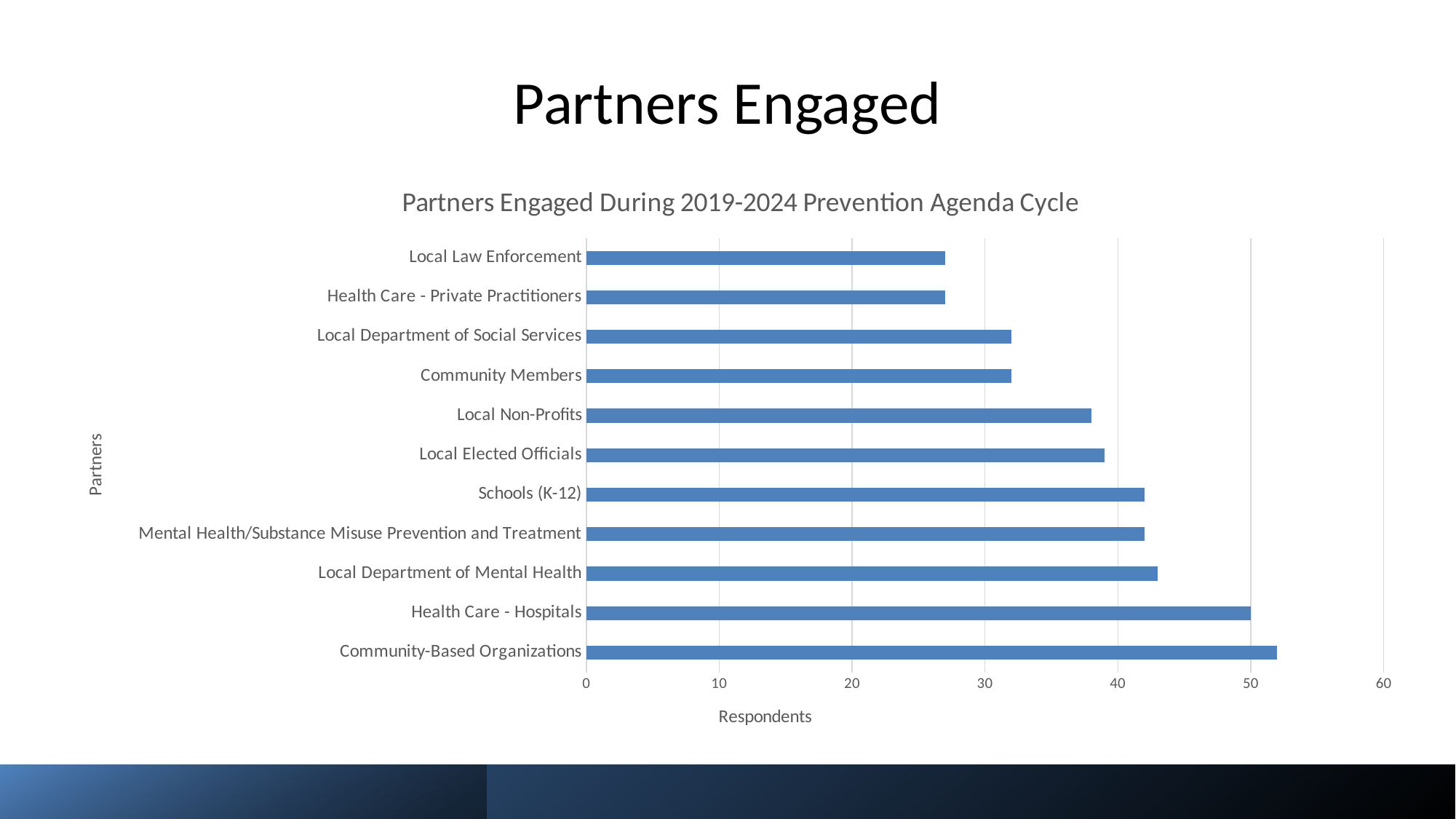
What kind of chart is shown on the slide? bar chart Is the value for Local Non-Profits greater or less than 40? less Is the value for Local Department of Mental Health greater or less than 40? greater How many partner categories are plotted in the chart? 11 What is the label on the horizontal axis of the chart? Respondents What is the title of the chart? Partners Engaged During 2019-2024 Prevention Agenda Cycle Which has more respondents, Local Non-Profits or Local Department of Social Services? Local Non-Profits Is the value for Community Members greater or less than 30? greater Which partner category has the highest number of respondents? Community-Based Organizations Which has more respondents, Health Care - Hospitals or Schools (K-12)? Health Care - Hospitals